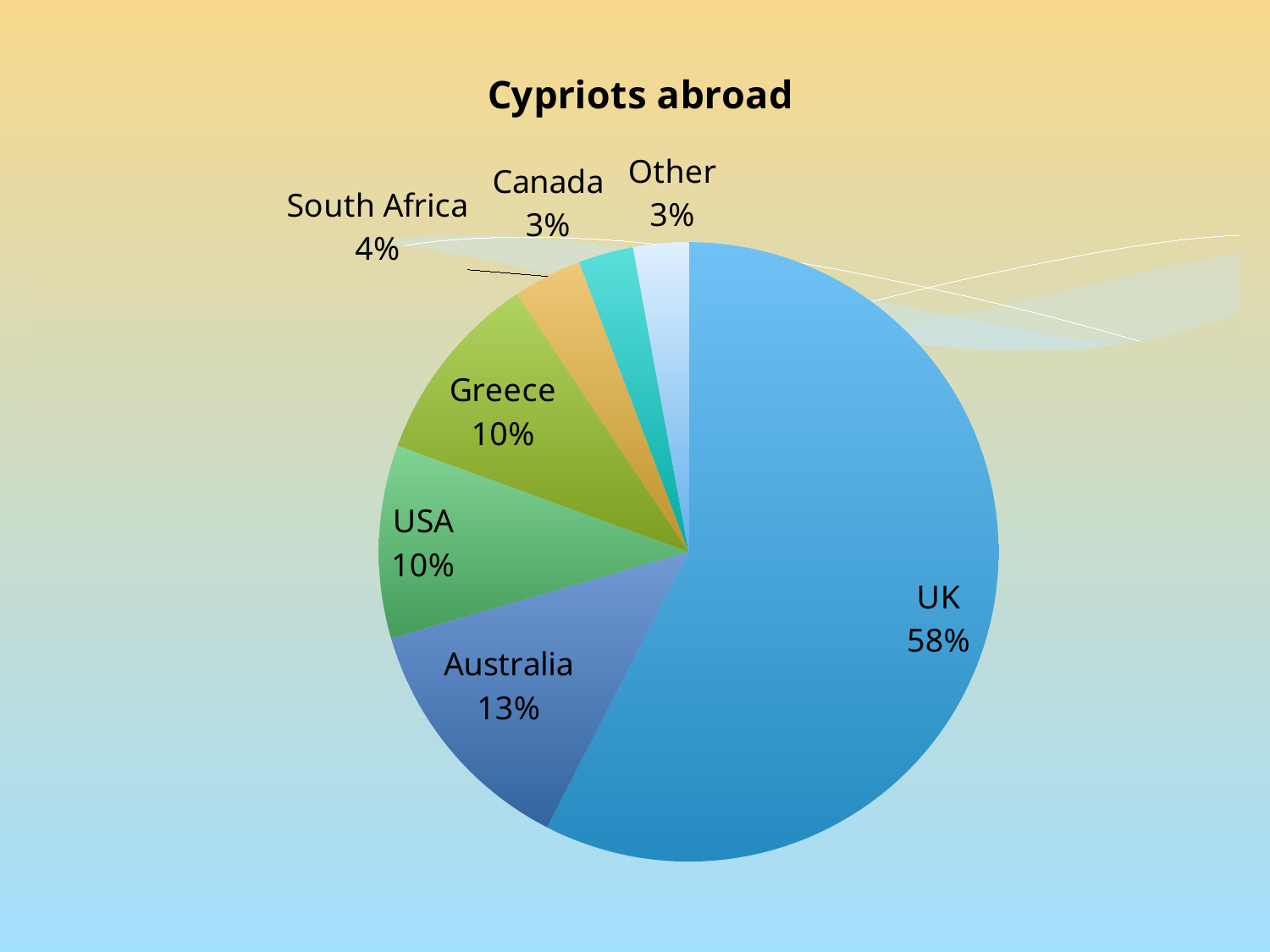
What kind of chart is shown on the slide? Pie chart What is the title of the chart? Cypriots abroad What percentage is shown for Australia? 13% What percentage is shown for Greece? 10% What is the combined share of the USA and Greece? 20% How many slices does the pie chart have? 7 Which is larger, the share for Australia or the share for Greece? Australia What percentage is shown for South Africa? 4% Which category has the largest slice of the pie? UK What share of Cypriots abroad live in the UK? 58% What percentage is shown for Canada? 3% What is the difference in percentage points between the UK and Australia? 45